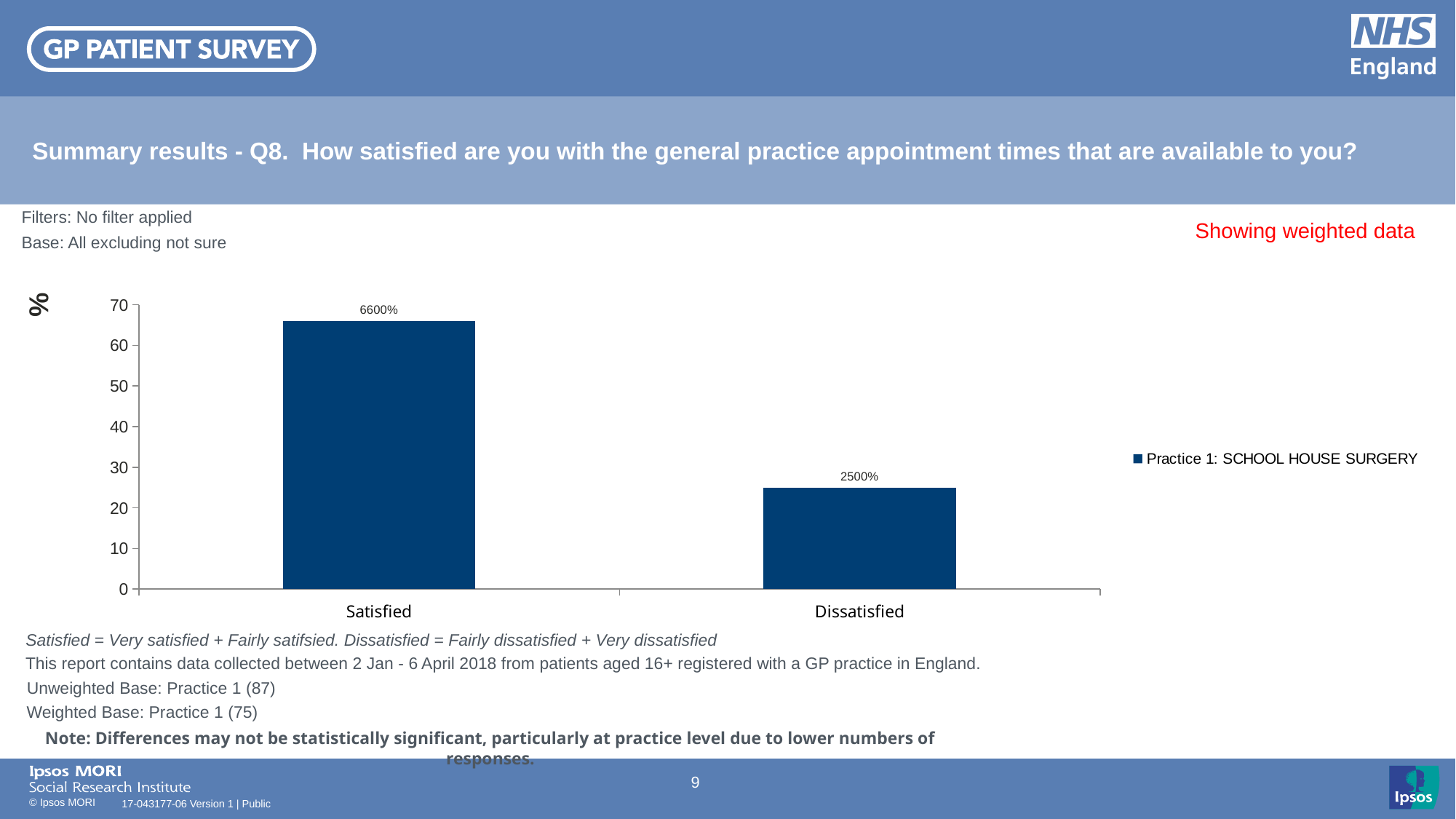
Which category has the lowest bar? Dissatisfied Which category has the highest bar? Satisfied How many series does the legend list? 1 What is the data label shown on the Satisfied bar? 6600% Which bar is taller, Satisfied or Dissatisfied? Satisfied Is the value for Dissatisfied greater or less than 30 on the axis? less What is the name of the series listed in the legend? Practice 1: SCHOOL HOUSE SURGERY What kind of chart is shown on the slide? Bar chart What is the maximum value shown on the vertical axis? 70 How many categories are shown on the x axis? 2 Is the value for Satisfied greater or less than 60 on the axis? greater What is the data label shown on the Dissatisfied bar? 2500%